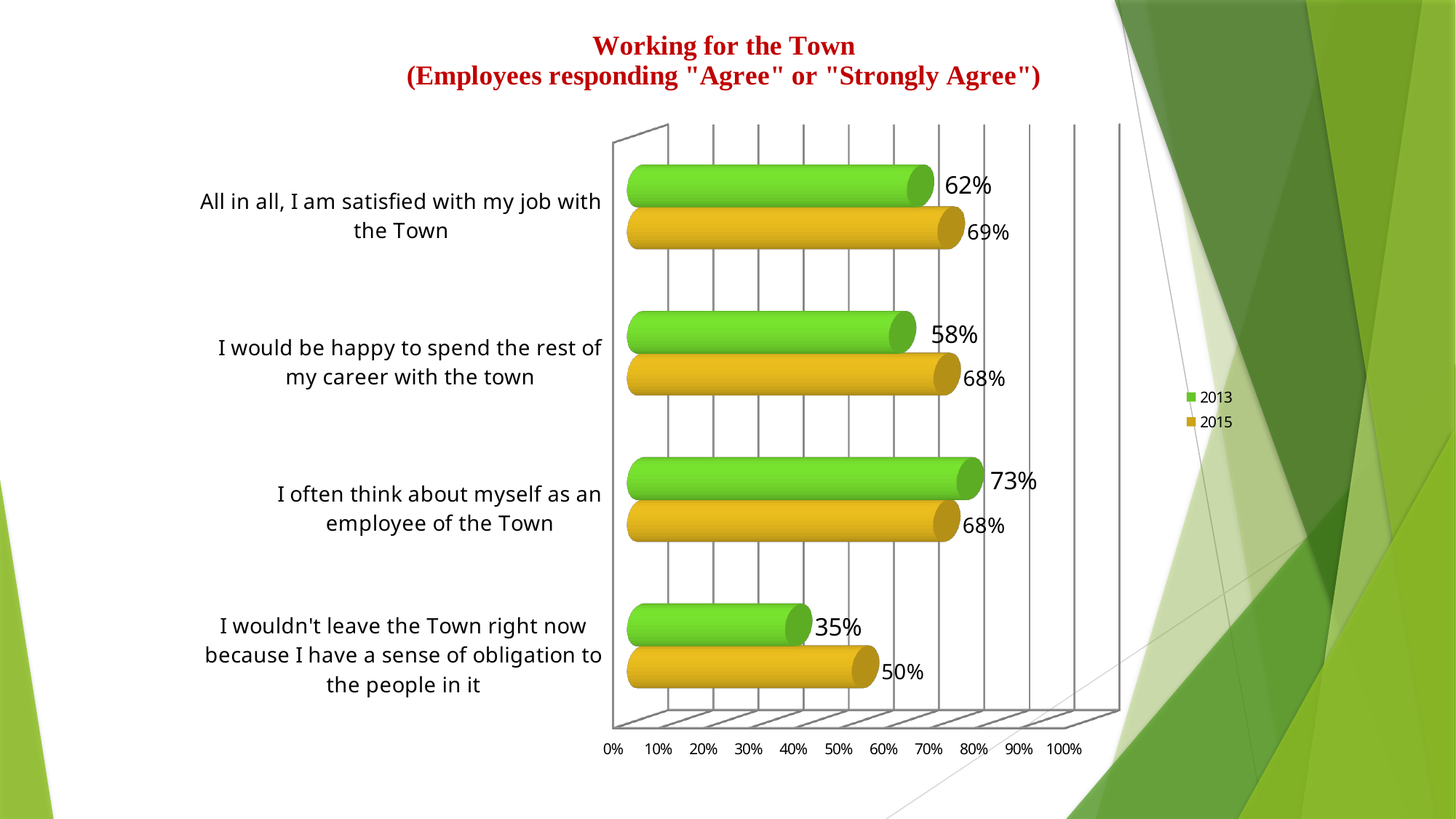
What is the 2013 value for "I wouldn't leave the Town right now because I have a sense of obligation to the people in it"? 35% How many series does the legend list? 2 For "I often think about myself as an employee of the Town", which year has the larger value, 2013 or 2015? 2013 What is the difference between the 2015 and 2013 values for "I would be happy to spend the rest of my career with the town"? 10% How many statements (categories) are shown in the chart? 4 What is the 2013 value for "I often think about myself as an employee of the Town"? 73% Which statement has the highest 2013 value? I often think about myself as an employee of the Town What kind of chart is shown on the slide? Bar chart What is the 2015 value for "All in all, I am satisfied with my job with the Town"? 69% Which statement has the lowest 2015 value? I wouldn't leave the Town right now because I have a sense of obligation to the people in it What is the difference between the 2015 and 2013 values for "I wouldn't leave the Town right now because I have a sense of obligation to the people in it"? 15% Which colour represents the 2015 series in the chart? Gold/yellow